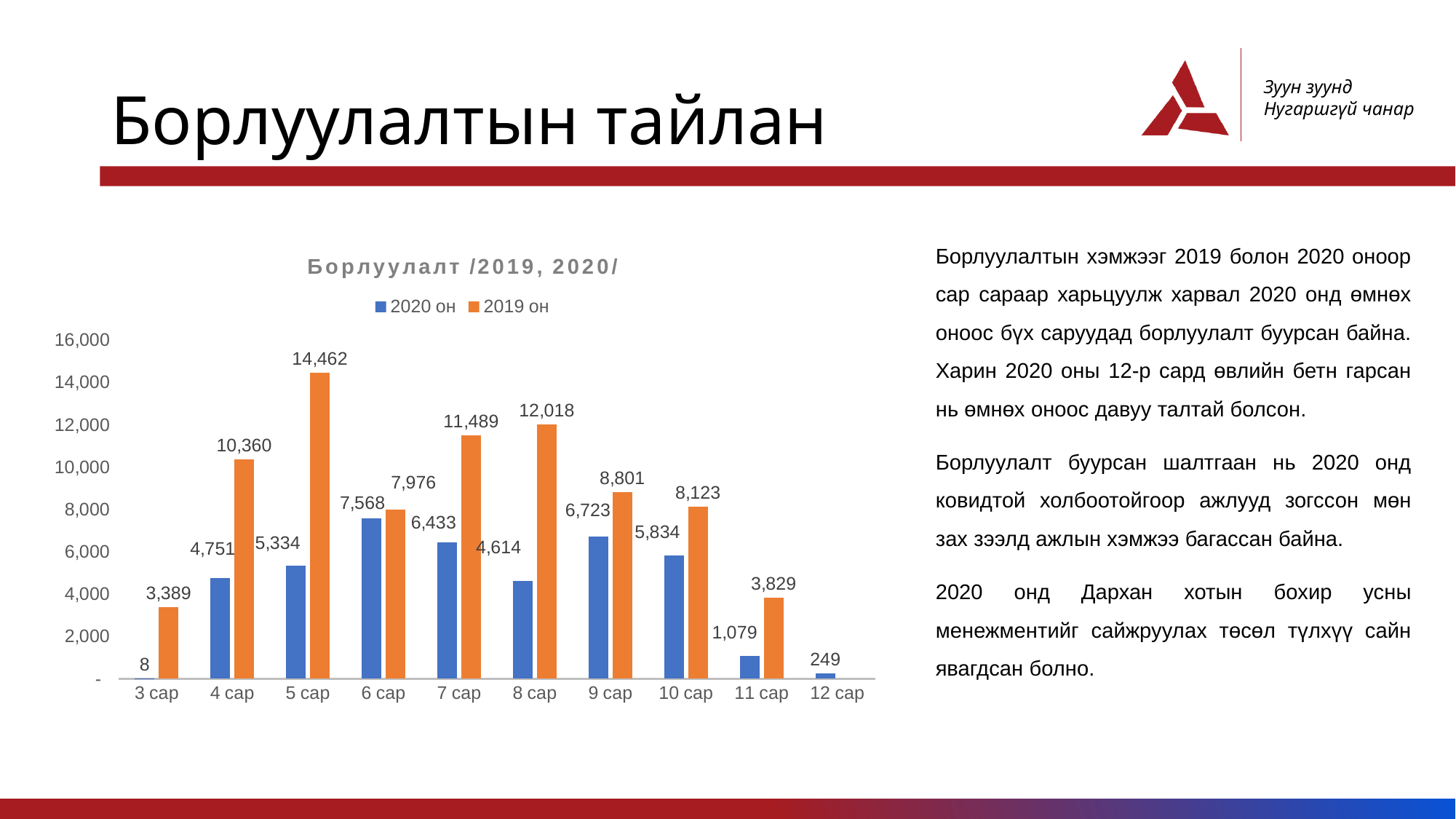
Which is larger in 6 сар: the 2020 он value or the 2019 он value? 2019 он What is the value for 2020 он in 11 сар? 1,079 What is the value for 2020 он in 6 сар? 7,568 How many series does the legend list? 2 What kind of chart is shown on the slide? Bar chart Which month has the highest value for 2019 он? 5 сар What is the value for 2019 он in 5 сар? 14,462 Is the value for 2019 он in 7 сар greater or less than 10,000? greater Which month has the lowest value for 2020 он? 3 сар How many months are shown on the x axis? 10 What is the difference between the 2019 он and 2020 он values in 8 сар? 7,404 What is the title of the chart? Борлуулалт /2019, 2020/